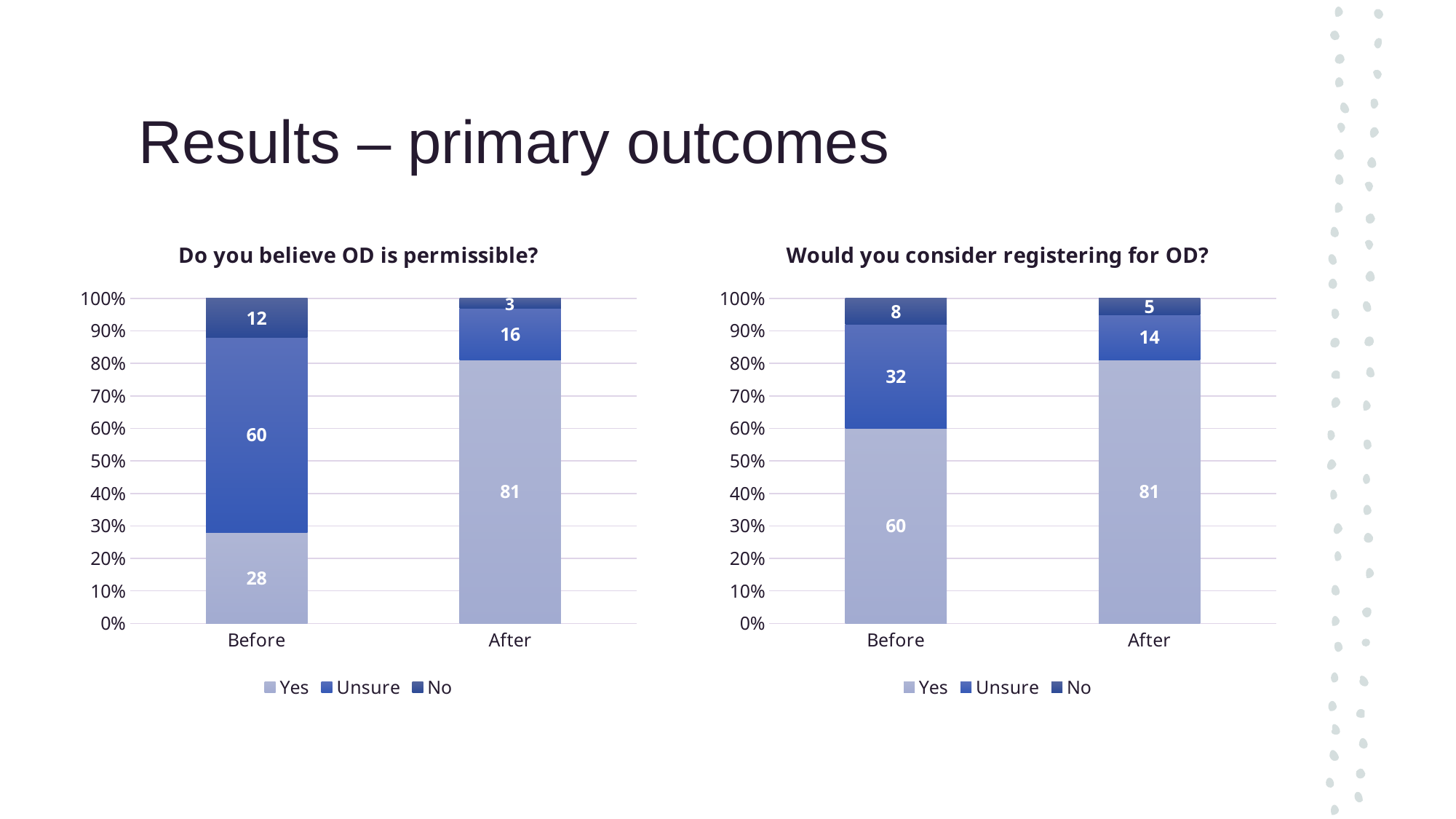
In the chart titled "Do you believe OD is permissible?", what is the difference between the Yes values for After and Before? 53 In the chart titled "Would you consider registering for OD?", what is the value for Yes in the After bar? 81 How many series does the legend list in the chart titled "Would you consider registering for OD?"? 3 In the chart titled "Do you believe OD is permissible?", what is the value for Yes in the Before bar? 28 How many categories are shown on the x axis of the chart titled "Would you consider registering for OD?"? 2 In the chart titled "Would you consider registering for OD?", which segment of the After bar is smallest? No What kind of chart is the chart titled "Do you believe OD is permissible?"? Stacked bar chart In the chart titled "Would you consider registering for OD?", what is the value for No in the Before bar? 8 In the chart titled "Do you believe OD is permissible?", which segment of the Before bar is largest? Unsure In the chart titled "Do you believe OD is permissible?", is the No value larger for Before or After? Before In the chart titled "Do you believe OD is permissible?", what is the value for Unsure in the After bar? 16 In the chart titled "Would you consider registering for OD?", what is the difference between the Unsure values for Before and After? 18